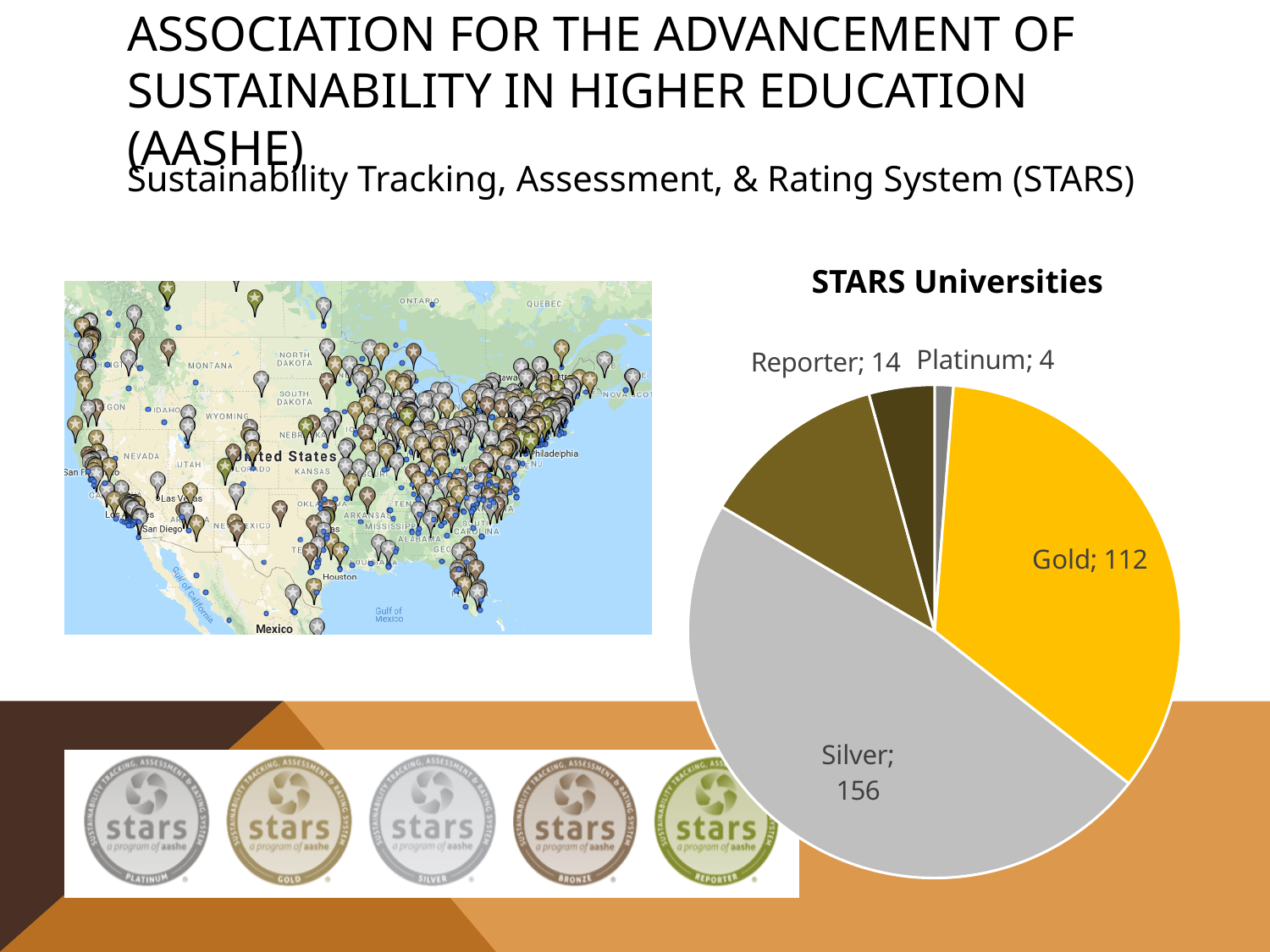
How many slices does the STARS Universities pie chart have? 5 In the STARS Universities pie chart, which is larger: Gold or Silver? Silver In the STARS Universities pie chart, what is the difference between the Reporter and Platinum values? 10 What is the title of the pie chart on the slide? STARS Universities In the STARS Universities pie chart, how many more universities are Silver than Gold? 44 Which category has the largest slice in the STARS Universities pie chart? Silver In the STARS Universities pie chart, what is the value for Reporter? 14 In the STARS Universities pie chart, how many universities are in the Gold category? 112 Which category has the smallest slice in the STARS Universities pie chart? Platinum In the STARS Universities pie chart, what is the value for Platinum? 4 What type of chart is shown under the title "STARS Universities"? pie chart In the STARS Universities pie chart, what is the value for Silver? 156